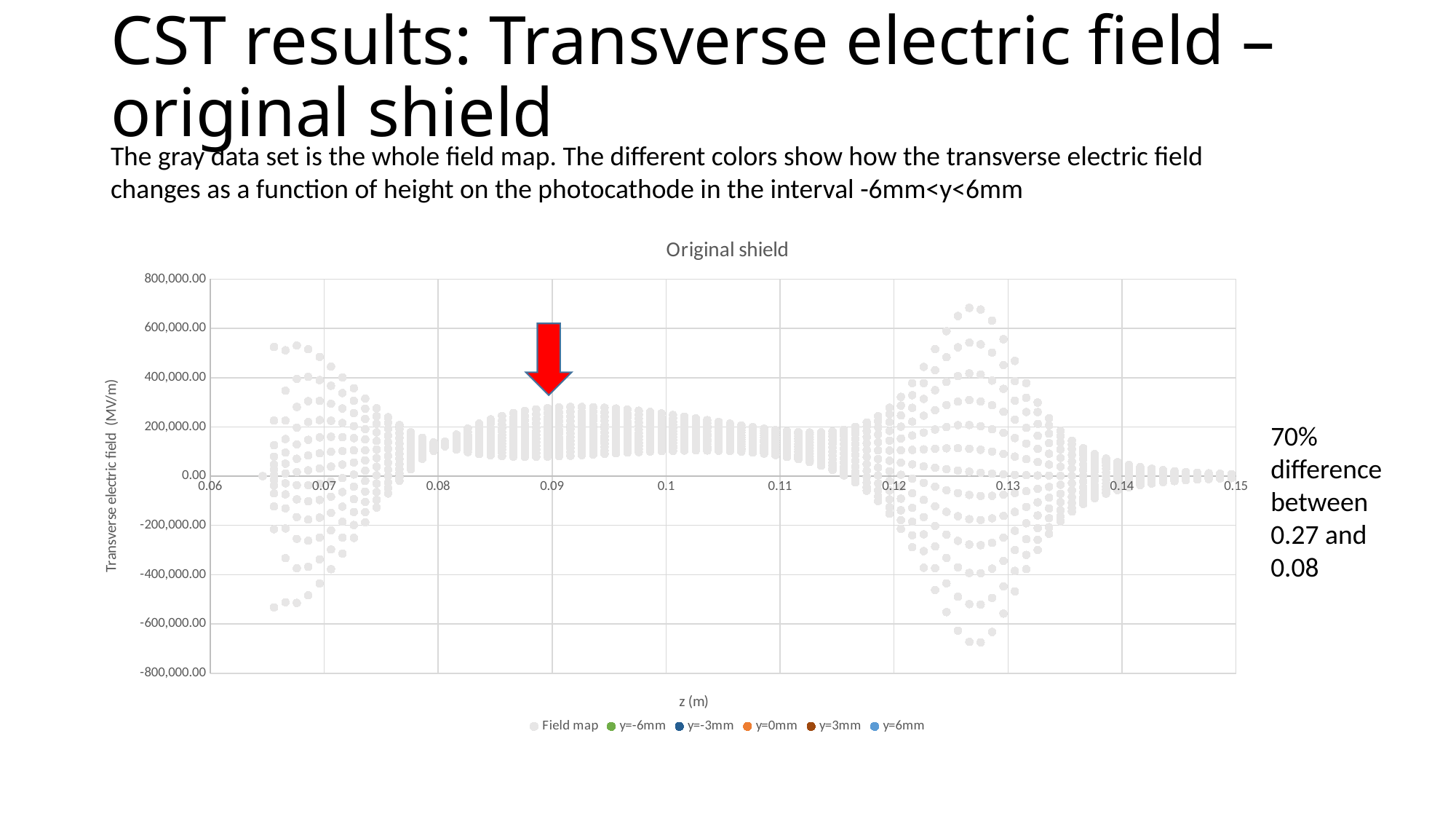
What is the label of the x axis of the chart? z (m) What is the largest z value shown on the x axis of the chart? 0.15 What is the lowest value shown on the y axis of the chart? -800,000.00 What is the smallest z value shown on the x axis of the chart? 0.06 What kind of chart is shown on the slide? scatter chart What is the title of the chart? Original shield Is the highest Field map value near z = 0.07 greater or less than 600,000.00? less Is the highest Field map value near z = 0.09 greater or less than 400,000.00? less Is the highest Field map value near z = 0.13 greater or less than 600,000.00? greater What is the highest value shown on the y axis of the chart? 800,000.00 How many series does the chart legend list? 6